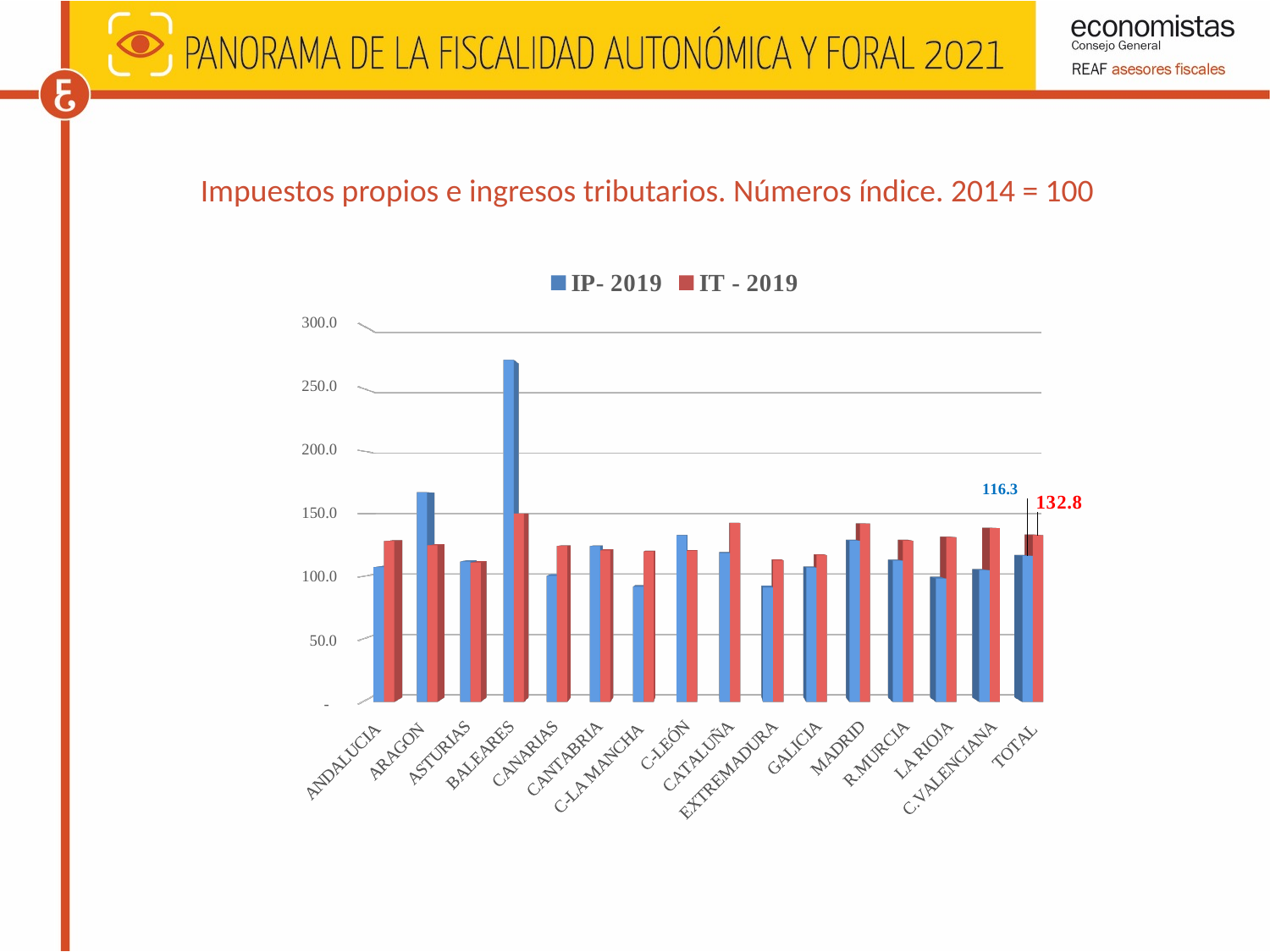
Is the IP- 2019 value for CANARIAS greater or less than 150? less Which category has the highest IP- 2019 value? BALEARES Is the IP- 2019 value for ARAGON greater or less than 150? greater For CATALUÑA, which is larger: the IP- 2019 value or the IT - 2019 value? IT - 2019 What kind of chart is shown on the slide? Bar chart Is the IP- 2019 value for BALEARES greater or less than 250? greater What is the value of IP- 2019 for TOTAL? 116.3 How many categories are shown on the x axis of the chart? 16 For ARAGON, which is larger: the IP- 2019 value or the IT - 2019 value? IP- 2019 What is the difference between the IT - 2019 and IP- 2019 values for TOTAL? 16.5 What is the value of IT - 2019 for TOTAL? 132.8 How many series does the legend list? 2